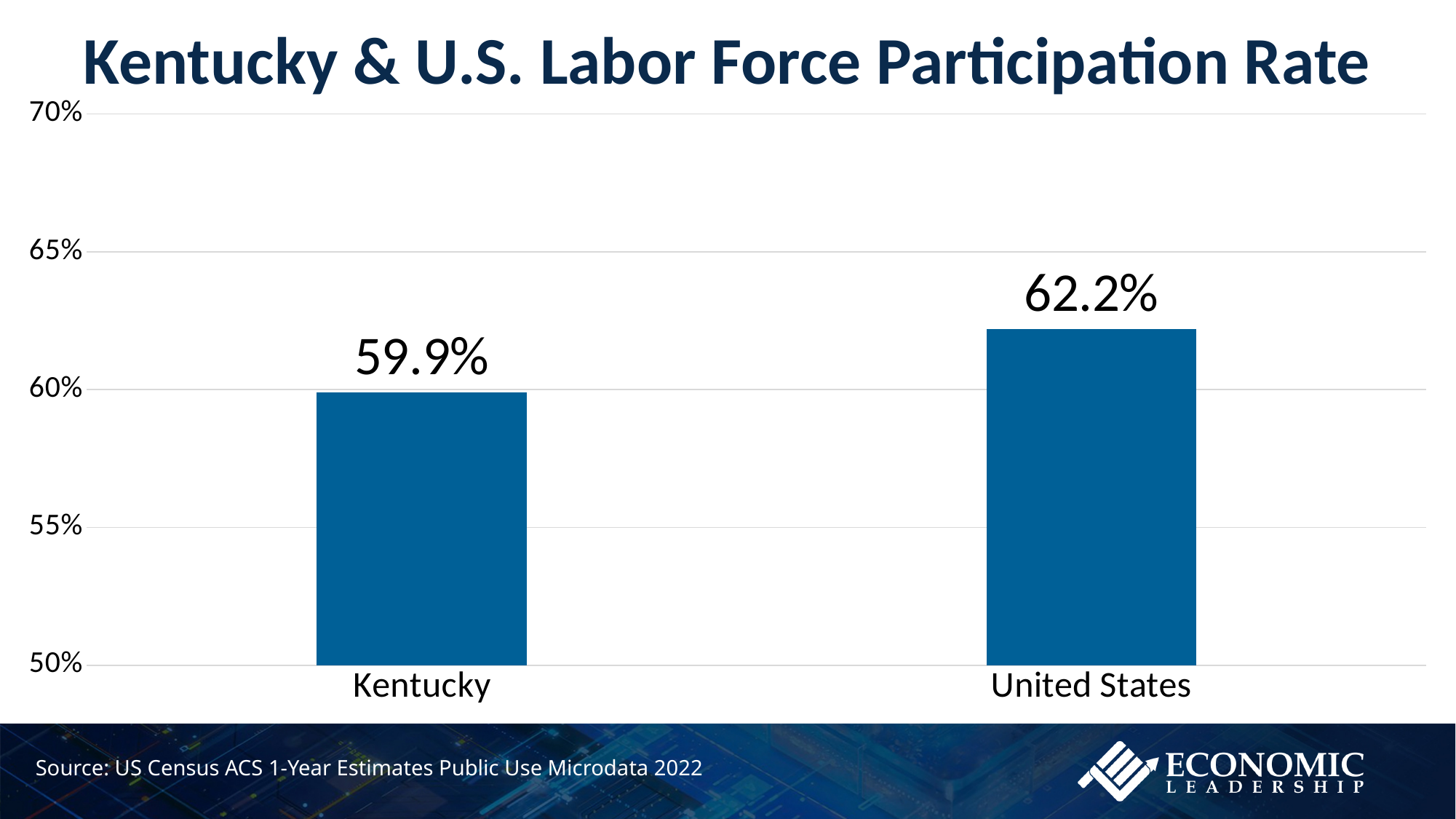
Is the value for Kentucky greater or less than 60%? less What is the highest value shown on the vertical axis? 70% Is the labor force participation rate higher for Kentucky or the United States? United States What kind of chart is shown on the slide? Bar chart Which category has the lower labor force participation rate? Kentucky What is the title of the chart? Kentucky & U.S. Labor Force Participation Rate What is the labor force participation rate for Kentucky? 59.9% Is the value for the United States greater or less than 60%? greater What is the labor force participation rate for the United States? 62.2% How many categories are shown in the chart? 2 Which category has the higher labor force participation rate? United States What is the difference between the United States and Kentucky labor force participation rates? 2.3%